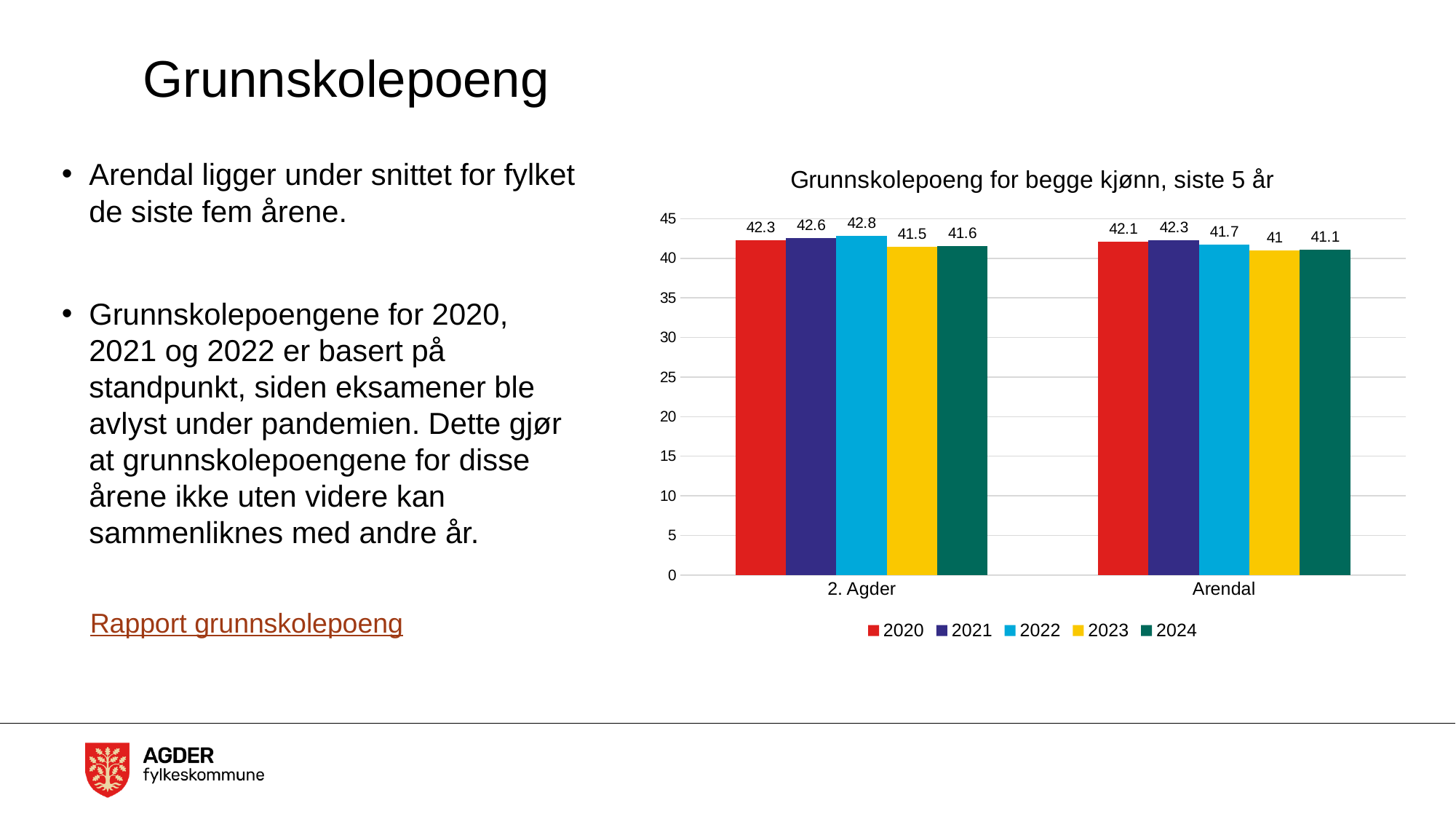
Which is larger, the 2024 value for 2. Agder or for Arendal? 2. Agder Which year has the lowest value for Arendal? 2023 What kind of chart is shown on the slide? Bar chart What is the value for 2. Agder in 2022? 42.8 What is the value for Arendal in 2023? 41 How many categories are shown on the x axis? 2 Which year has the highest value for 2. Agder? 2022 What is the value for Arendal in 2020? 42.1 How many series does the legend list? 5 What is the title of the chart? Grunnskolepoeng for begge kjønn, siste 5 år What is the difference between the 2022 values for 2. Agder and Arendal? 1.1 Is the value for Arendal in 2021 greater or less than 40? greater